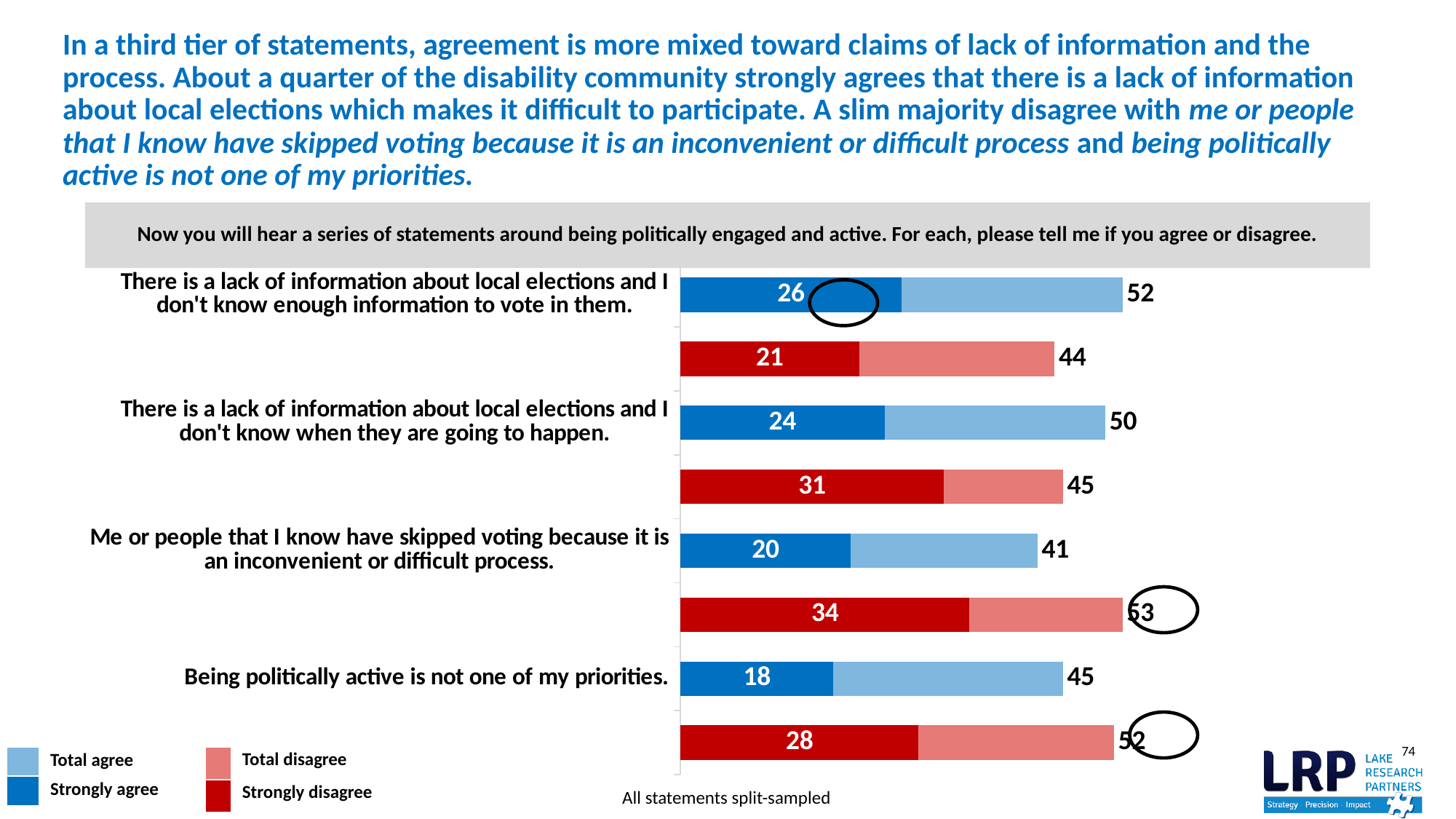
Which statement has the lowest strongly agree value? Being politically active is not one of my priorities. Which statement has the highest strongly agree value? There is a lack of information about local elections and I don't know enough information to vote in them. What is the strongly disagree value for the statement "Me or people that I know have skipped voting because it is an inconvenient or difficult process"? 34 What is the difference between the total agree and total disagree values for the statement "Being politically active is not one of my priorities"? 7 What is the total disagree value for the statement "There is a lack of information about local elections and I don't know when they are going to happen"? 45 What is the total agree value for the statement "There is a lack of information about local elections and I don't know enough information to vote in them"? 52 How many series does the legend list? 4 What is the strongly agree value for the statement "Being politically active is not one of my priorities"? 18 Which statement has the highest total disagree value? Me or people that I know have skipped voting because it is an inconvenient or difficult process. How many statements are shown in the chart? 4 What kind of chart is shown on the slide? Bar chart For the statement "Me or people that I know have skipped voting because it is an inconvenient or difficult process", which is larger: total agree or total disagree? Total disagree